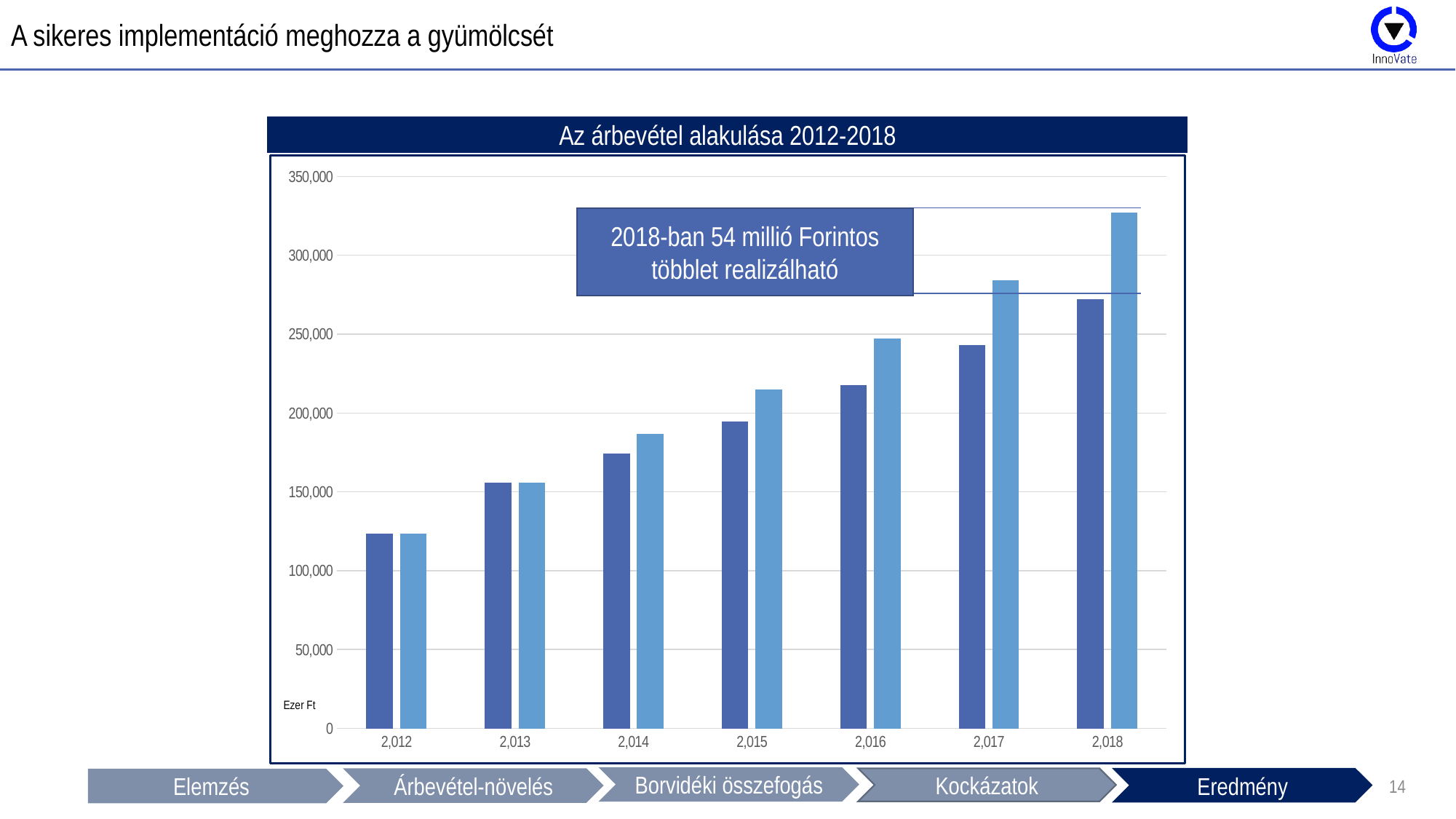
Is the value of the dark blue bar for 2,012 greater or less than 150,000? less Which year has the tallest bar in the chart? 2,018 How many bars are plotted for each year in the chart? 2 Which year has the lowest bars in the chart? 2,012 Is the value of the light blue bar for 2,017 greater or less than 300,000? less Is the value of the light blue bar for 2,018 greater or less than 300,000? greater How many years are shown on the x axis of the chart? 7 What is the title of the chart? Az árbevétel alakulása 2012-2018 Do the values in the chart generally rise or fall from 2012 to 2018? rise For 2,018, which bar is taller, the dark blue bar or the light blue bar? the light blue bar What kind of chart is shown on the slide? bar chart What unit is indicated on the y axis of the chart? Ezer Ft